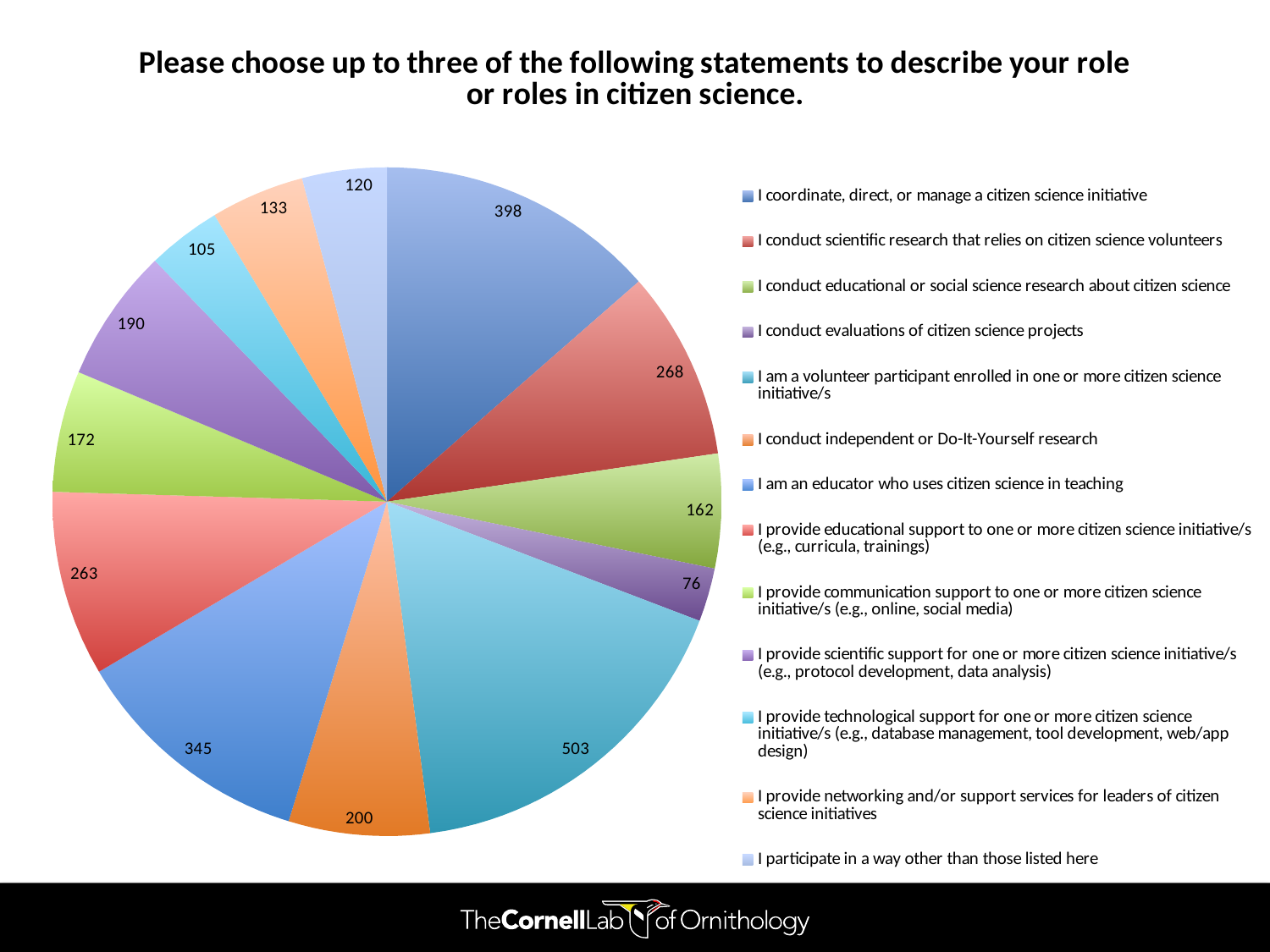
What is the value for "I coordinate, direct, or manage a citizen science initiative"? 398 What type of chart is shown on the slide? Pie chart How many slices does the pie chart have? 13 How many entries does the legend list? 13 Which is larger: the value for "I conduct scientific research that relies on citizen science volunteers" or the value for "I provide educational support to one or more citizen science initiative/s"? I conduct scientific research that relies on citizen science volunteers What is the value for "I am an educator who uses citizen science in teaching"? 345 Which category has the smallest slice of the pie? I conduct evaluations of citizen science projects What is the value for "I am a volunteer participant enrolled in one or more citizen science initiative/s"? 503 Which category has the largest slice of the pie? I am a volunteer participant enrolled in one or more citizen science initiative/s What is the difference between the value for "I am a volunteer participant enrolled in one or more citizen science initiative/s" and the value for "I am an educator who uses citizen science in teaching"? 158 What is the title of the chart? Please choose up to three of the following statements to describe your role or roles in citizen science. What is the value for "I conduct evaluations of citizen science projects"? 76